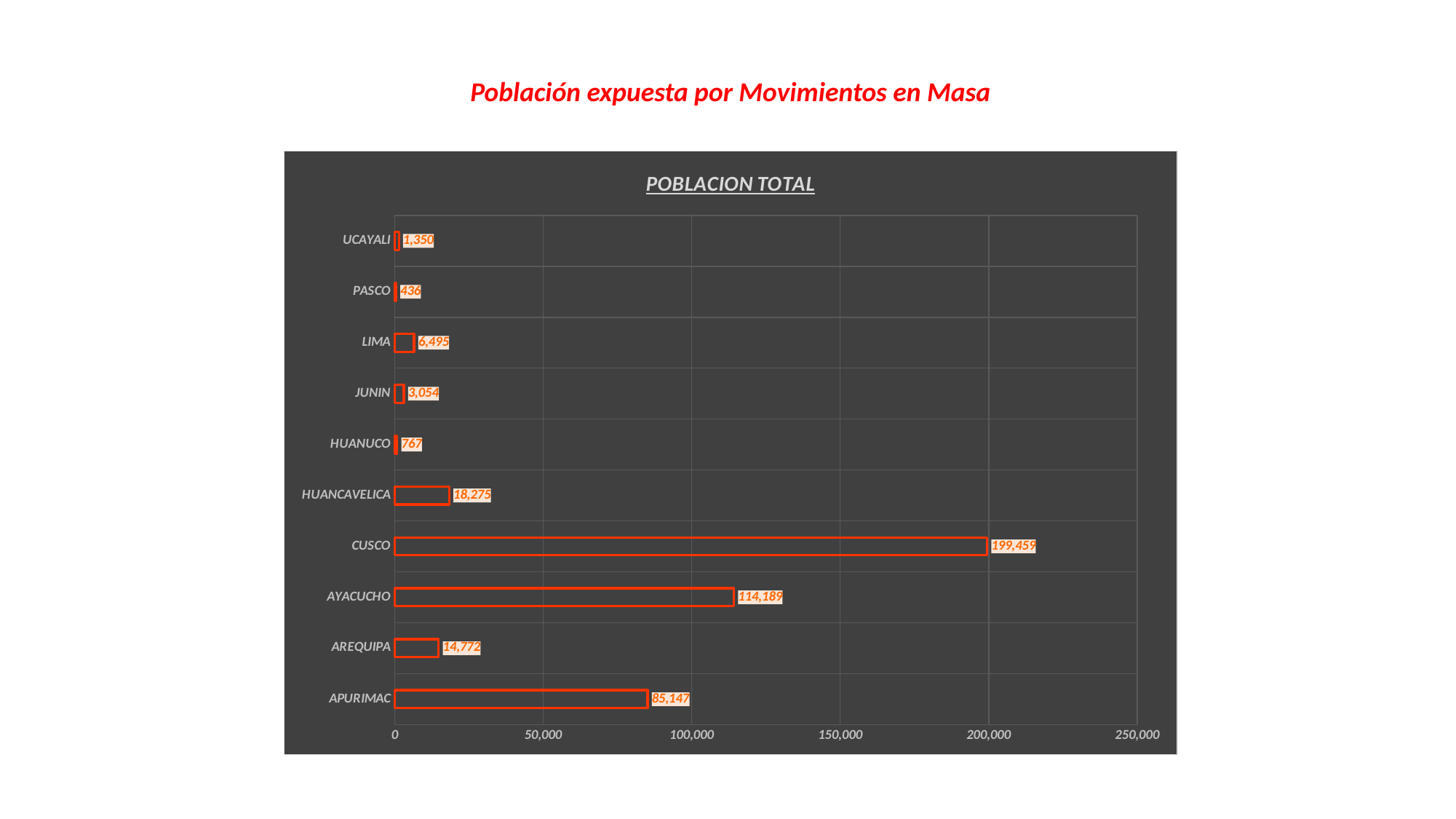
What is the title of the chart? POBLACION TOTAL What is the value for HUANCAVELICA? 18,275 How many categories are shown in the chart? 10 What is the difference between the values for CUSCO and AYACUCHO? 85,270 What is the value for LIMA? 6,495 Which is larger, the value for AREQUIPA or the value for HUANCAVELICA? HUANCAVELICA Is the value for APURIMAC greater or less than 100,000? less Which category has the lowest value? PASCO Which category has the highest value? CUSCO What is the value for CUSCO? 199,459 What is the value for PASCO? 436 What kind of chart is shown? bar chart